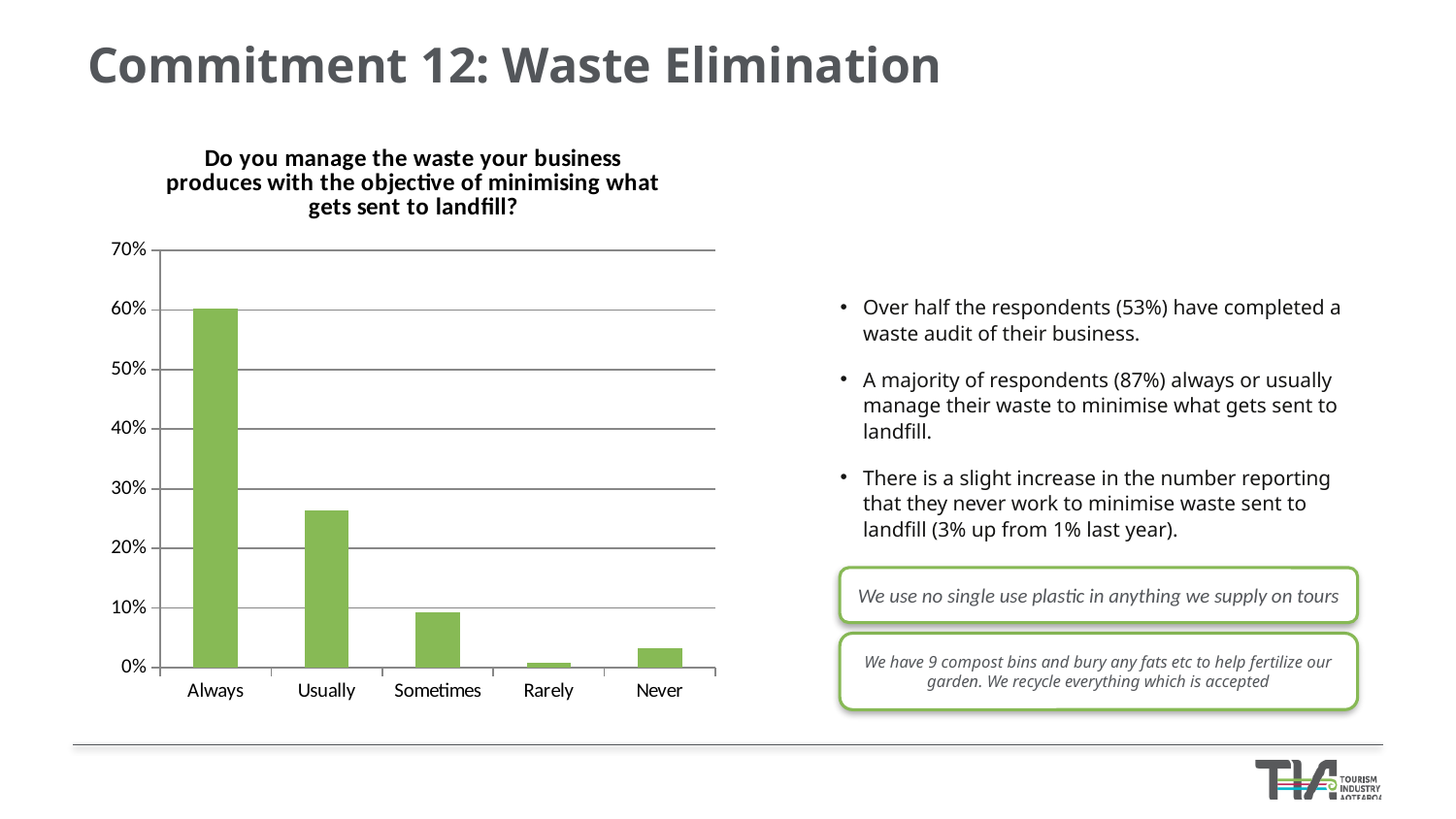
Is the value for Sometimes greater or less than 10%? less How many categories are shown on the x axis of the chart? 5 Which is larger, the value for Never or the value for Rarely? Never Do the values generally rise or fall from Always to Rarely along the x axis? fall Is the value for Never greater or less than 10%? less Is the value for Usually greater or less than 30%? less Which category has the lowest value in the chart? Rarely Which is larger, the value for Usually or the value for Sometimes? Usually What is the title of the chart? Do you manage the waste your business produces with the objective of minimising what gets sent to landfill? What kind of chart is shown on the slide? bar chart Which category has the highest value in the chart? Always